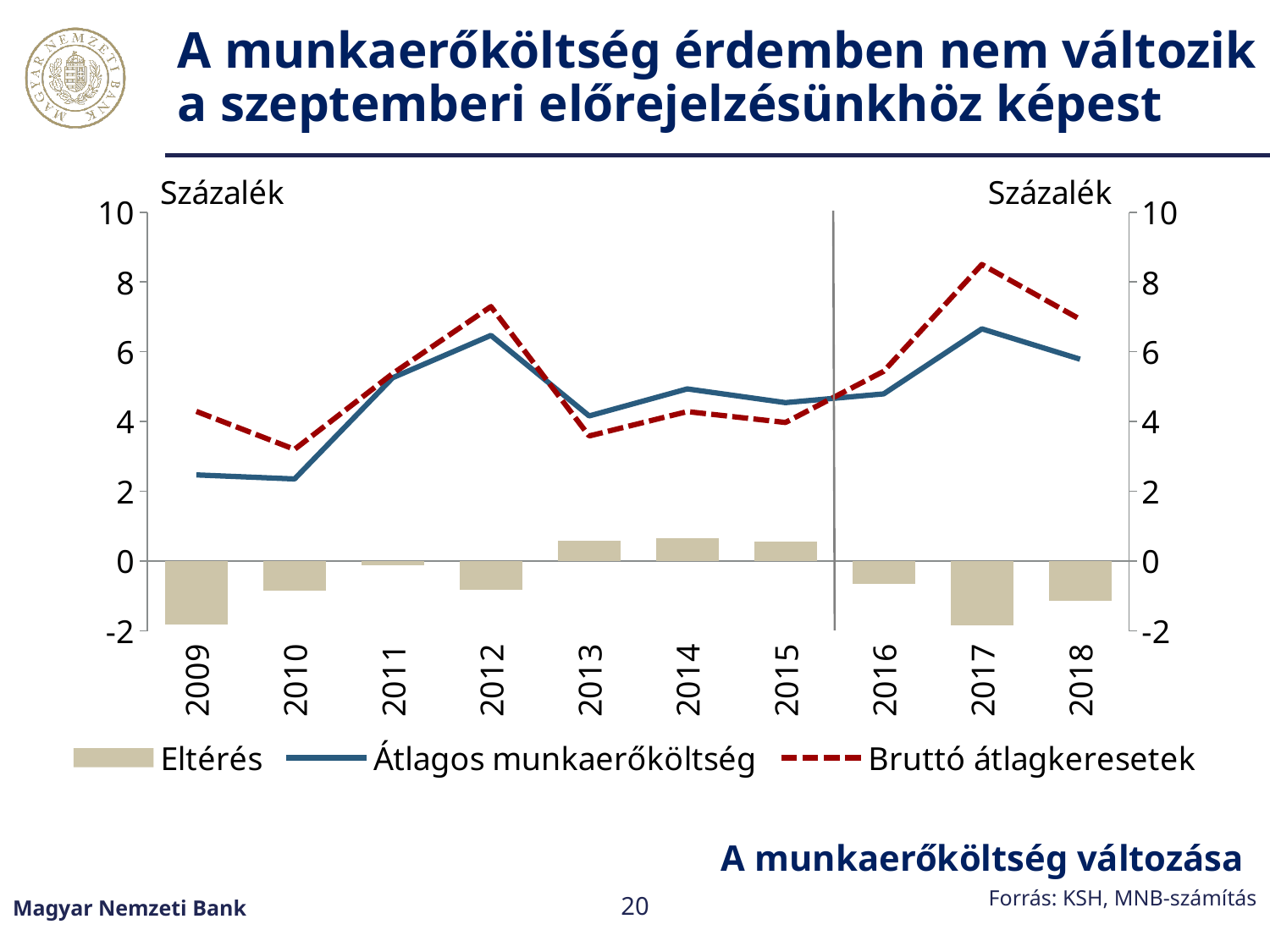
Is the Eltérés bar for 2009 greater or less than -1? less In which year does the Bruttó átlagkeresetek series reach its highest value? 2017 Is the value of Bruttó átlagkeresetek in 2013 greater or less than 4? less Does the Bruttó átlagkeresetek series rise or fall from 2015 to 2017? rise Is the value of Bruttó átlagkeresetek in 2017 greater or less than 8? greater How many years are shown on the x axis? 10 In 2015, which is larger: Átlagos munkaerőköltség or Bruttó átlagkeresetek? Átlagos munkaerőköltség What unit is shown on the vertical axes of the chart? Százalék How many series does the legend list? 3 What kind of chart is this? Combined bar and line chart In 2012, which is larger: Átlagos munkaerőköltség or Bruttó átlagkeresetek? Bruttó átlagkeresetek